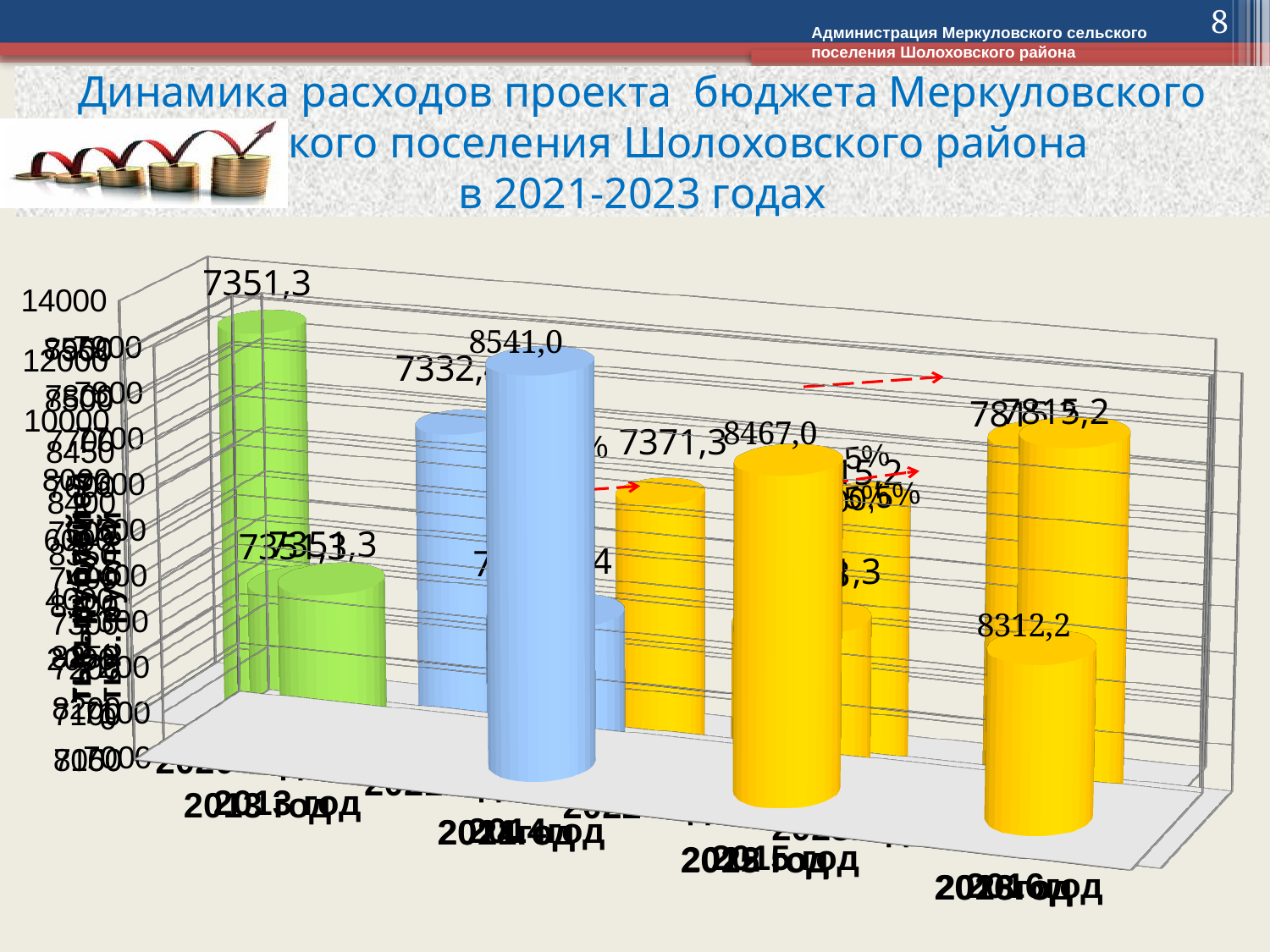
What three colours are used for the cylinders in the chart? green, blue and yellow Which years does the chart title say the budget expenditure dynamics cover? 2021-2023 Which is larger: the value printed above the tallest blue cylinder or the value printed above the tallest green cylinder? the blue cylinder (8541,0) What kind of chart is shown on the slide? bar chart What is the difference between the value above the tallest blue cylinder (8541,0) and the value above the tallest green cylinder (7351,3)? 1189,7 What is the highest tick value shown on the leftmost vertical axis? 14000 What value is printed above the tallest green cylinder? 7351,3 What value is printed above the tallest blue cylinder? 8541,0 What value is printed above the short yellow cylinder at the front right of the chart? 8312,2